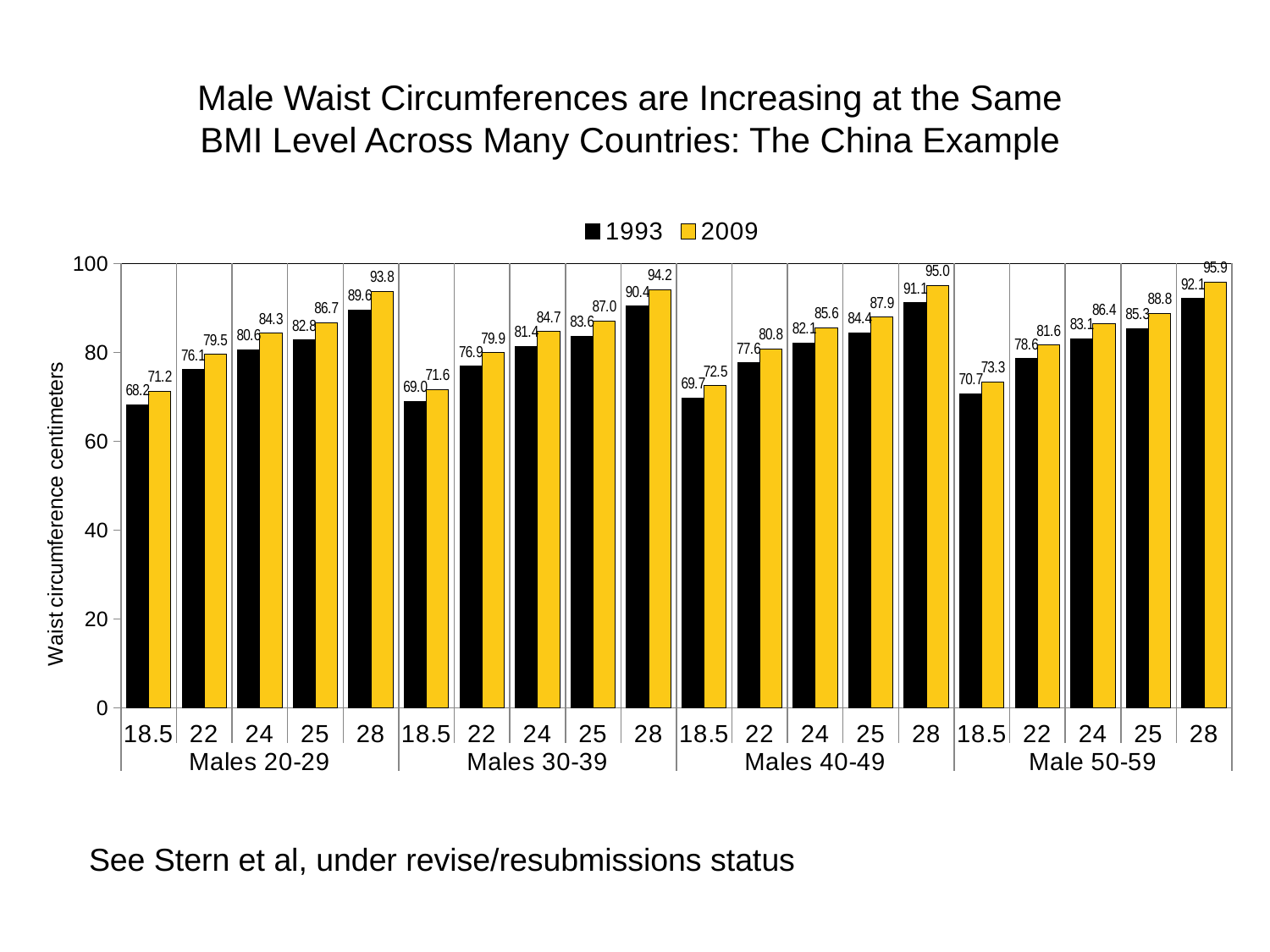
Which is larger: the 1993 value for BMI 24 in Males 40-49 or the 2009 value for BMI 22 in Males 20-29? 1993 value for BMI 24 in Males 40-49 How many series does the legend list? 2 What kind of chart is shown on the slide? bar chart What is the 1993 waist circumference for BMI 28 in the Males 20-29 group? 89.6 How many BMI-level categories (bar groups) are shown across all age groups? 20 Which bar has the lowest 1993 value on the chart? BMI 18.5, Males 20-29 (68.2) Is the 2009 value for BMI 28 in the Males 30-39 group greater or less than 90? greater What is the 2009 waist circumference for BMI 18.5 in the Males 40-49 group? 72.5 For BMI 25 in the Males 30-39 group, how much larger is the 2009 value than the 1993 value? 3.4 Within the Males 20-29 group, do the 2009 values rise or fall as BMI increases from 18.5 to 28? rise Which bar has the highest 2009 value on the chart? BMI 28, Male 50-59 (95.9) For BMI 22 in the Male 50-59 group, what is the difference between the 2009 and 1993 values? 3.0